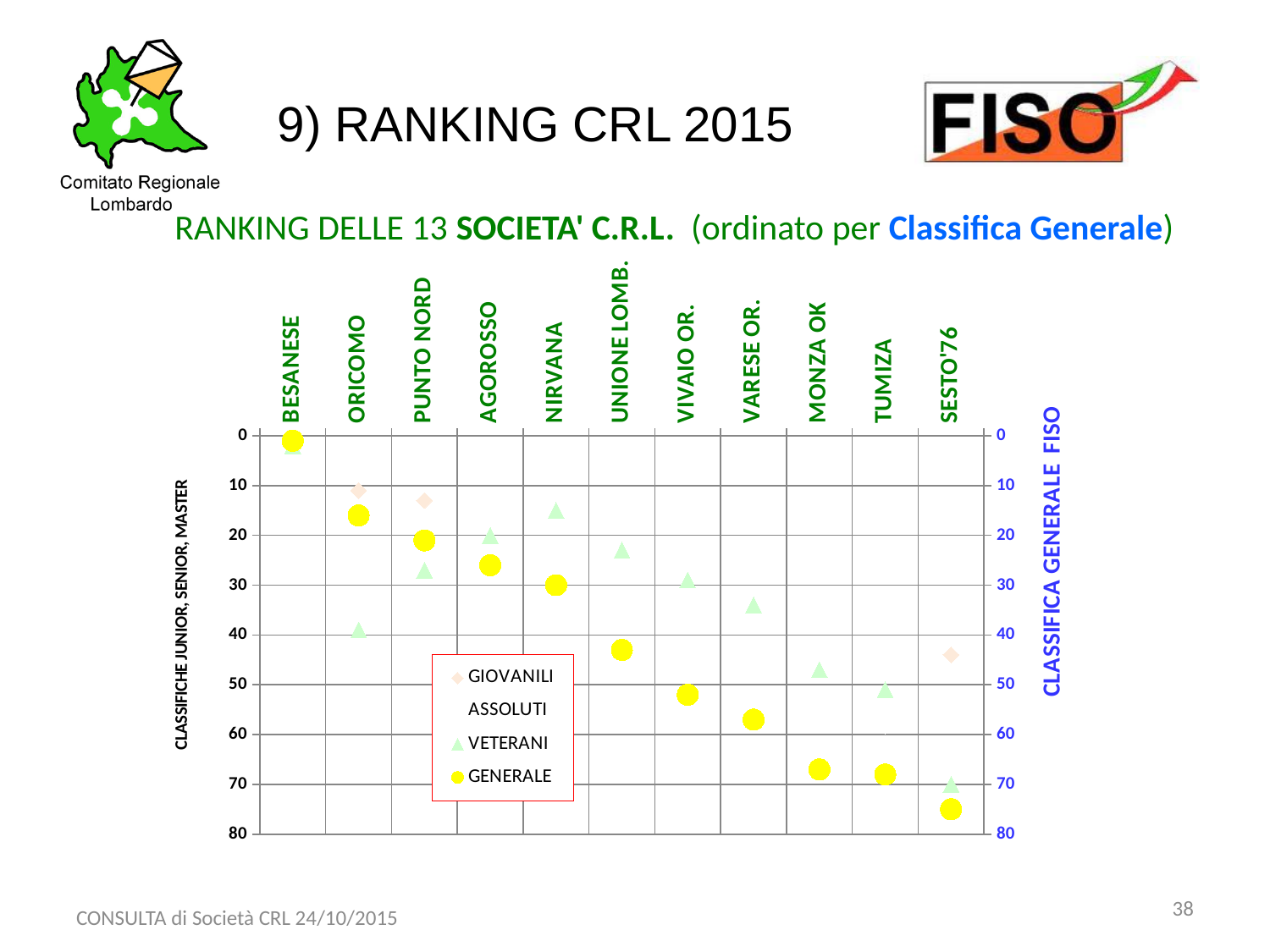
Is the VETERANI value for NIRVANA greater or less than 20? less Do the GENERALE values rise or fall numerically moving from BESANESE to SESTO'76 along the x axis? rise How many series does the chart legend list? 4 What kind of chart is shown on the slide? scatter chart Is the GENERALE value for UNIONE LOMB. greater or less than 40? greater What is the label of the right-hand vertical axis of the chart? CLASSIFICA GENERALE FISO Is the GENERALE value for ORICOMO greater or less than 20? less Which society has the largest GENERALE value on the chart? SESTO'76 Which society has the smallest GENERALE value on the chart? BESANESE How many societies are labelled along the x axis of the chart? 11 Which has the larger GENERALE value, VARESE OR. or VIVAIO OR.? VARESE OR.